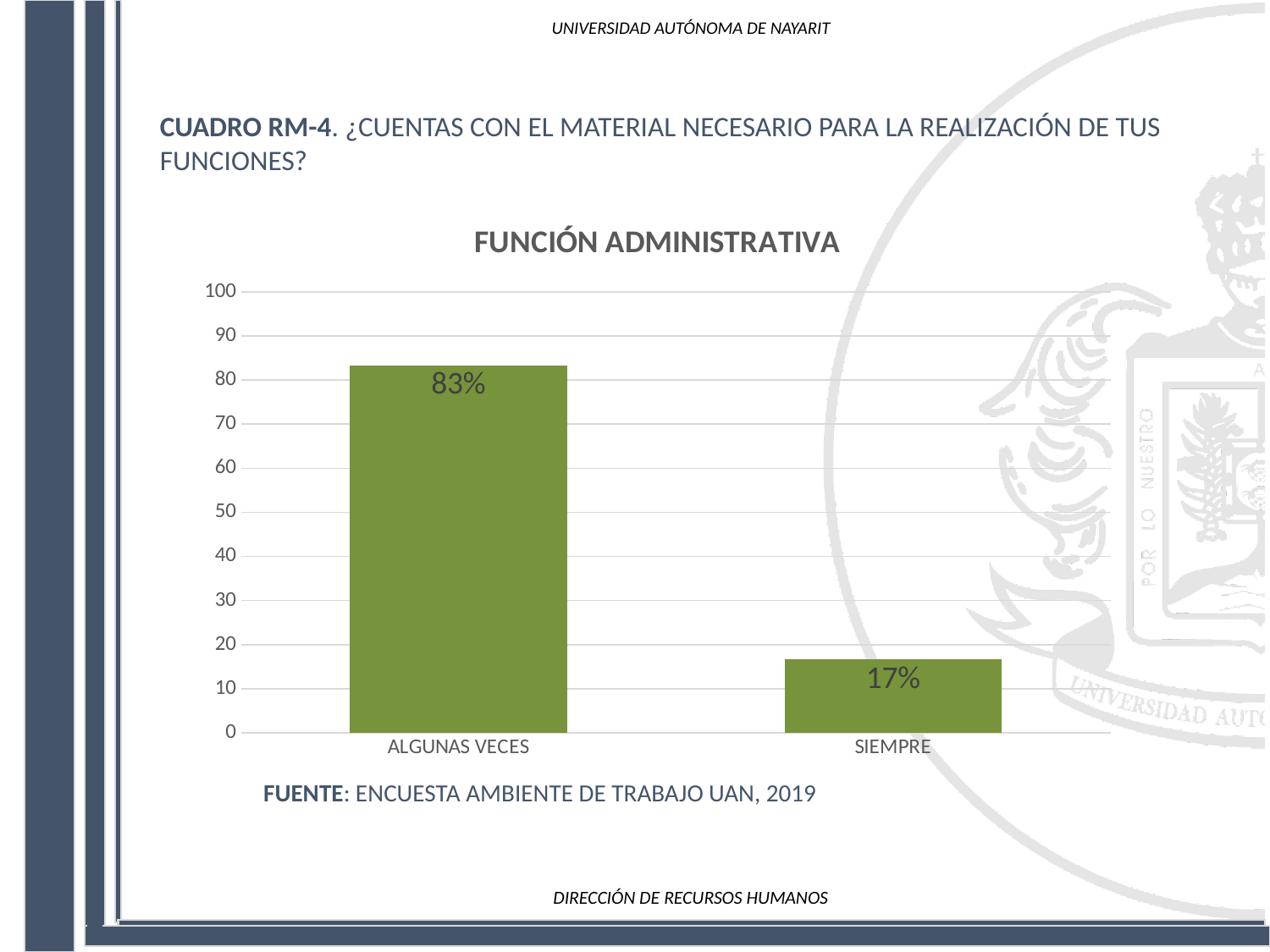
What is the title of the chart? FUNCIÓN ADMINISTRATIVA What is the highest value shown on the y axis? 100 Which is larger, the value for ALGUNAS VECES or the value for SIEMPRE? ALGUNAS VECES What is the difference between the values for ALGUNAS VECES and SIEMPRE? 66% Which category has the highest value? ALGUNAS VECES Which category has the lowest value? SIEMPRE What kind of chart is shown on the slide? bar chart Is the value for SIEMPRE greater or less than 20? less Is the value for ALGUNAS VECES greater or less than 80? greater How many categories are shown on the x axis? 2 What is the value for SIEMPRE? 17% What is the value for ALGUNAS VECES? 83%